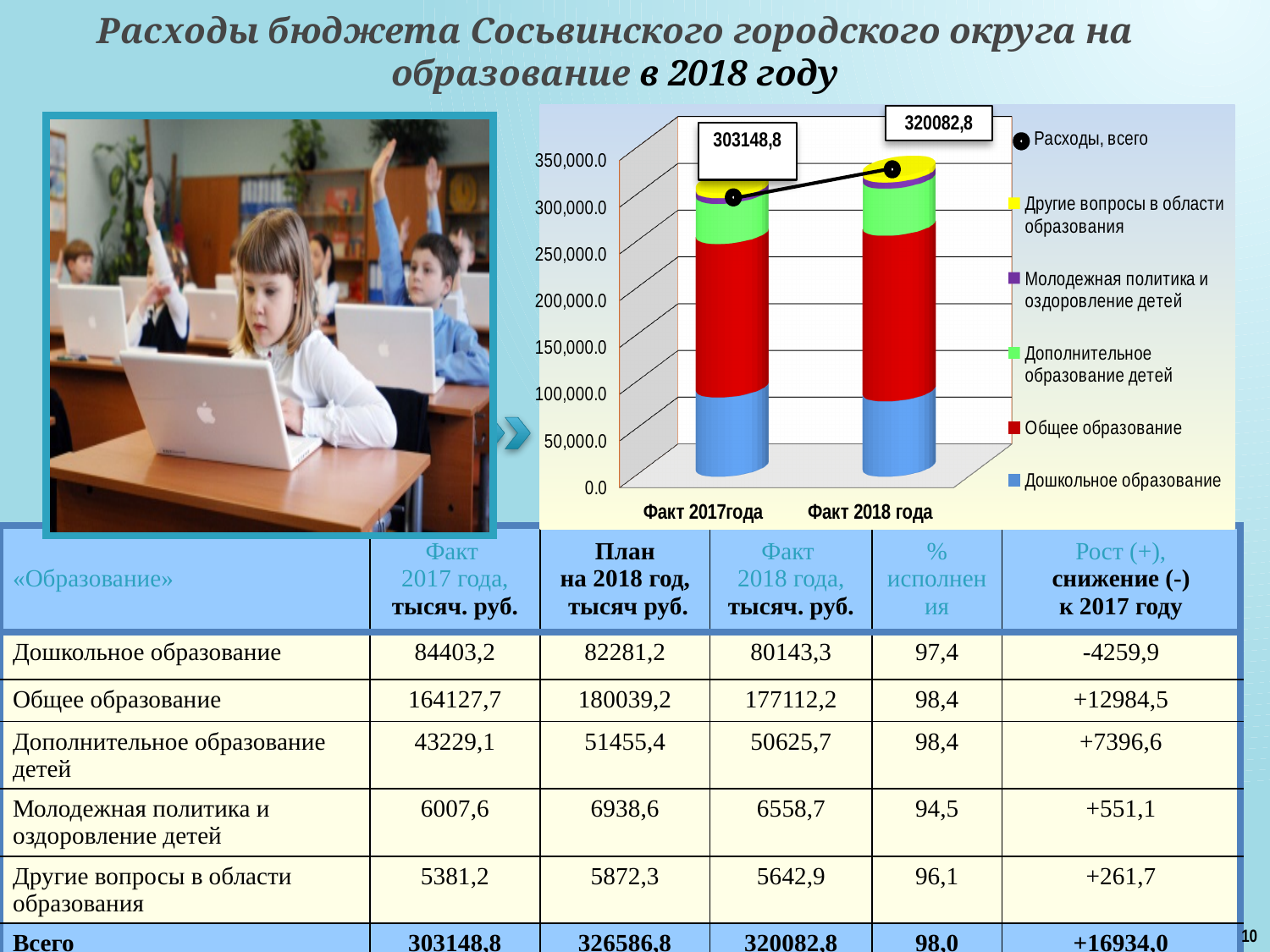
Which category has the highest value of Расходы, всего? Факт 2018 года What is the value of Расходы, всего for Факт 2018 года? 320082,8 Does Расходы, всего rise or fall from Факт 2017 года to Факт 2018 года? rise How many categories are shown on the x axis of the chart? 2 Is the value of the Дошкольное образование segment for Факт 2017 года greater or less than 100,000.0? less What kind of chart is shown on the slide? bar chart What is the value of Расходы, всего for Факт 2017 года? 303148,8 How many series does the chart legend list? 6 Is the value of Расходы, всего for Факт 2017 года greater or less than 250,000.0? greater Which is larger for Расходы, всего: Факт 2017 года or Факт 2018 года? Факт 2018 года By how much does Расходы, всего for Факт 2018 года exceed Факт 2017 года? 16934,0 What colour represents Общее образование in the chart? red